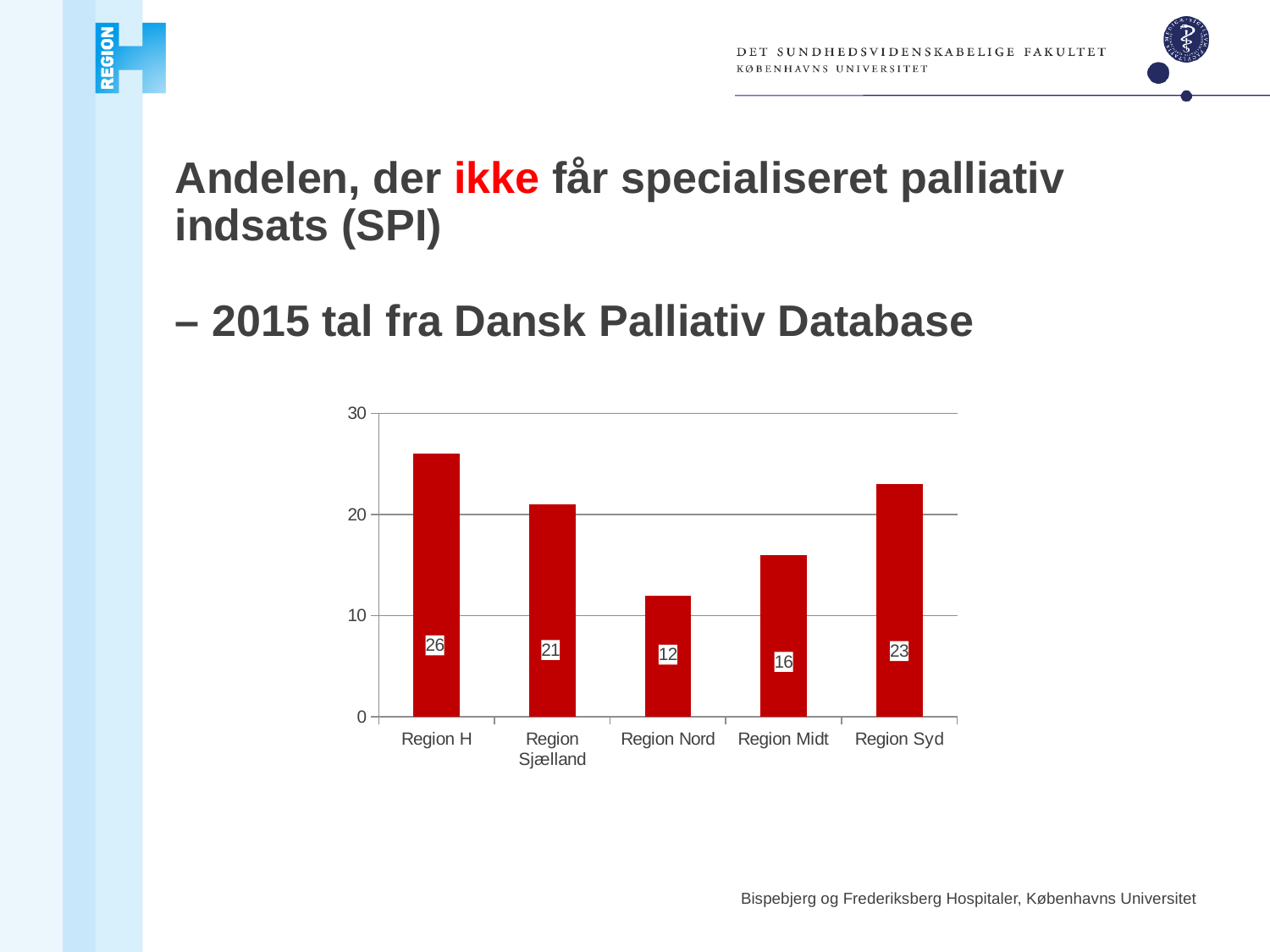
What is the value for Region Nord? 12 What is the value for Region H? 26 What kind of chart is shown on the slide? bar chart What is the value for Region Midt? 16 What is the value for Region Sjælland? 21 Which region has the highest value? Region H What is the value for Region Syd? 23 How many regions are shown in the chart? 5 Which region has the lowest value? Region Nord What is the difference between the values for Region H and Region Nord? 14 Is the value for Region Midt greater or less than 20? less Which is larger, the value for Region Sjælland or the value for Region Syd? Region Syd